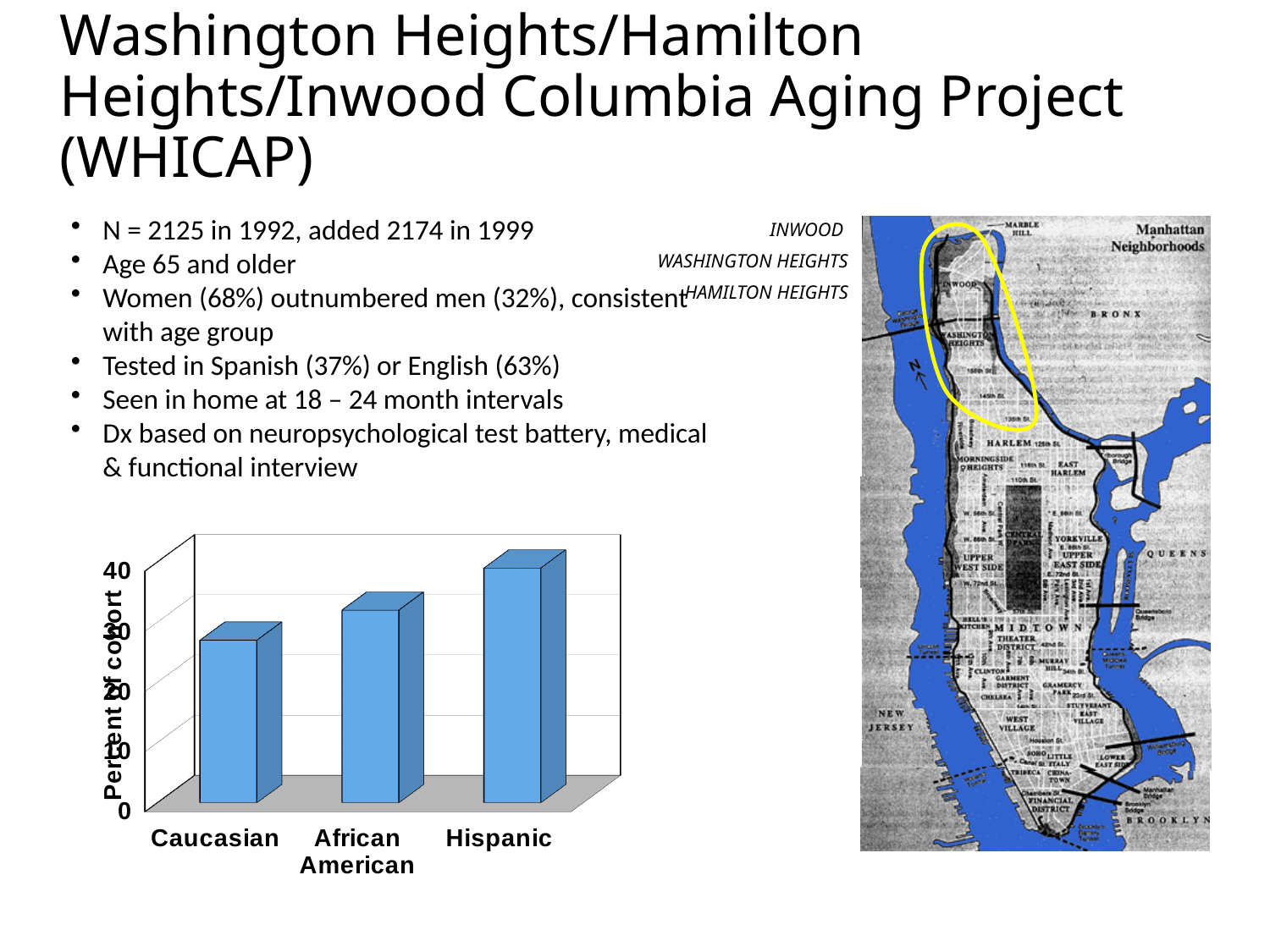
Which is larger in the bar chart, the value for Hispanic or the value for Caucasian? Hispanic Is the value for Hispanic greater or less than 30? greater What kind of chart is shown on the slide? bar chart Which category has the highest percent of cohort in the bar chart? Hispanic Do the values in the bar chart rise or fall from left to right across the categories? rise Is the value for Caucasian greater or less than 20? greater Which category has the lowest percent of cohort in the bar chart? Caucasian Which is larger in the bar chart, the value for African American or the value for Caucasian? African American What is the label on the vertical axis of the bar chart? Percent of cohort Is the value for African American greater or less than 20? greater How many categories are shown on the x axis of the bar chart? 3